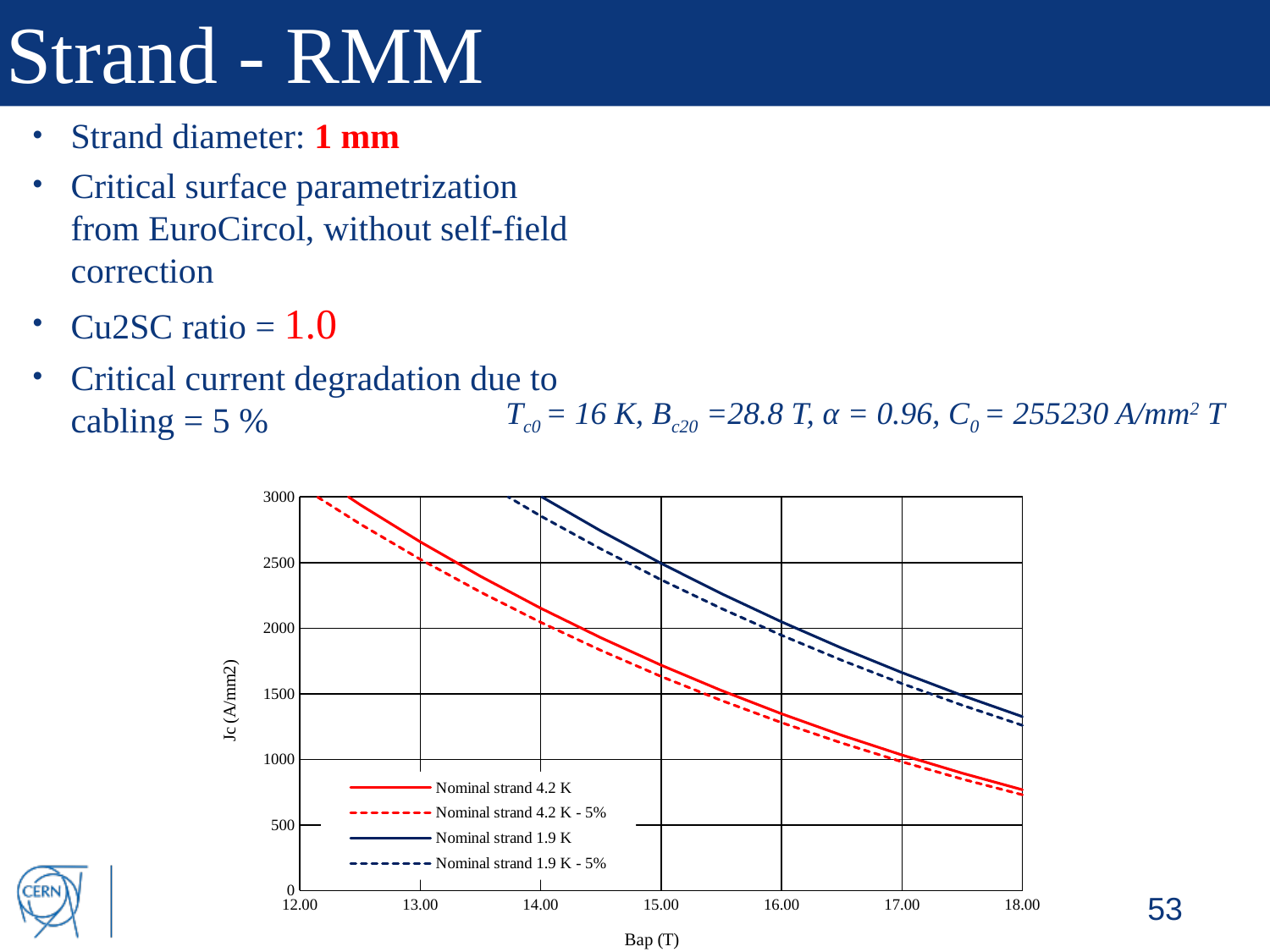
Is the value of Nominal strand 4.2 K at 18.00 T greater or less than 1000? less Is the value of Nominal strand 4.2 K at 15.00 T greater or less than 1500? greater What is the label of the x axis of the chart? Bap (T) Is the value of Nominal strand 1.9 K at 17.00 T greater or less than 1500? greater How many series does the chart legend list? 4 At 14.00 T, which is larger: Nominal strand 4.2 K or Nominal strand 4.2 K - 5%? Nominal strand 4.2 K Do the Jc values rise or fall as Bap increases along the x axis? fall What kind of chart is shown on the slide? line chart What colour are the Nominal strand 1.9 K lines in the chart? dark blue At 16.00 T, which is larger: Nominal strand 1.9 K or Nominal strand 4.2 K? Nominal strand 1.9 K